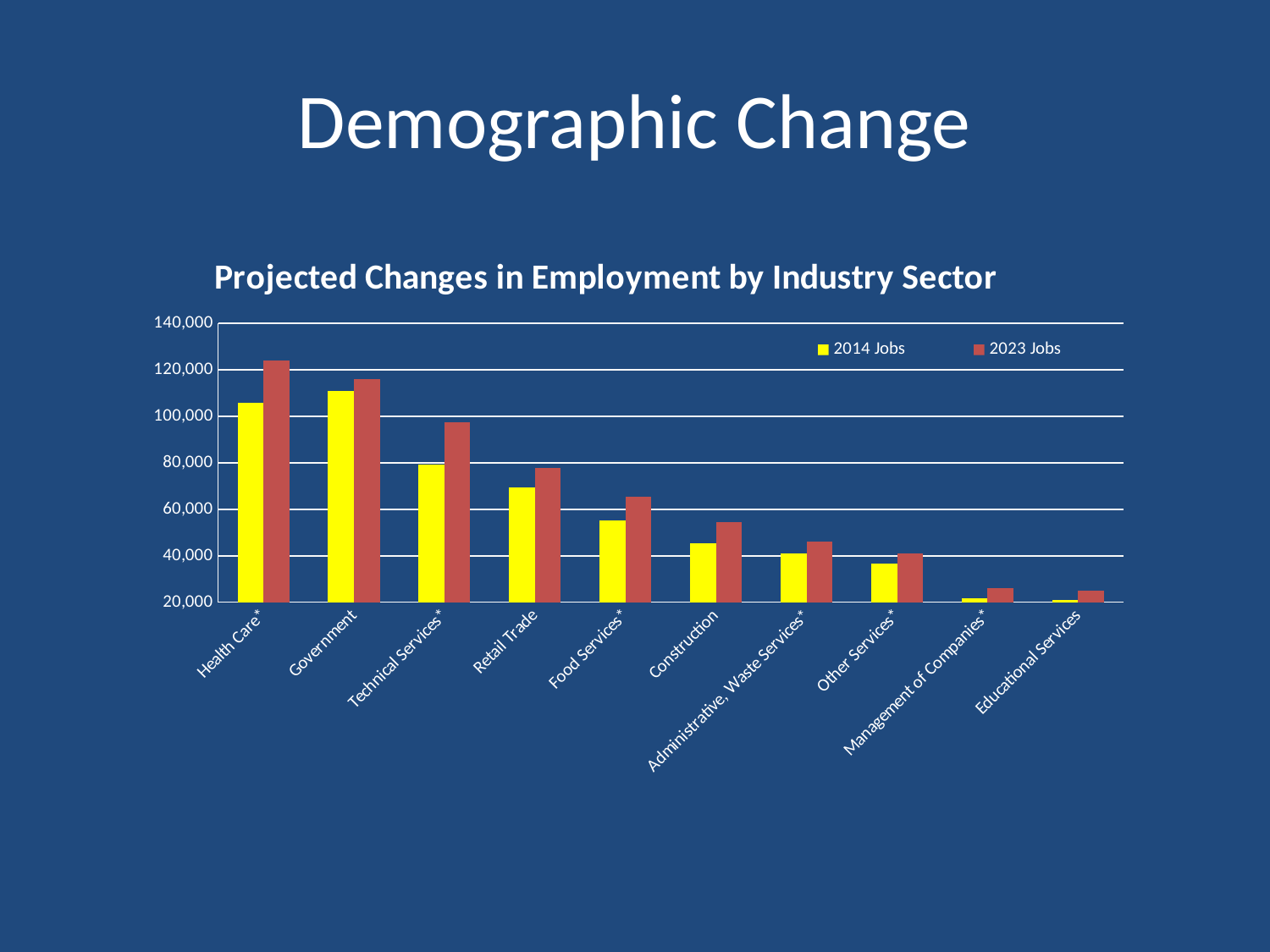
How many industry sectors are shown on the x axis? 10 Is the 2023 Jobs value for Food Services* greater or less than 60,000? greater How many series does the legend list? 2 Do the 2023 Jobs values generally rise or fall moving left to right along the x axis? fall What kind of chart is shown on the slide? bar chart Is the 2023 Jobs value for Health Care* greater or less than 120,000? greater Is the 2014 Jobs value for Other Services* greater or less than 40,000? less Which industry sector has the highest 2023 Jobs value? Health Care* Which is larger: the 2023 Jobs value for Health Care* or for Government? Health Care* What is the title of the chart? Projected Changes in Employment by Industry Sector